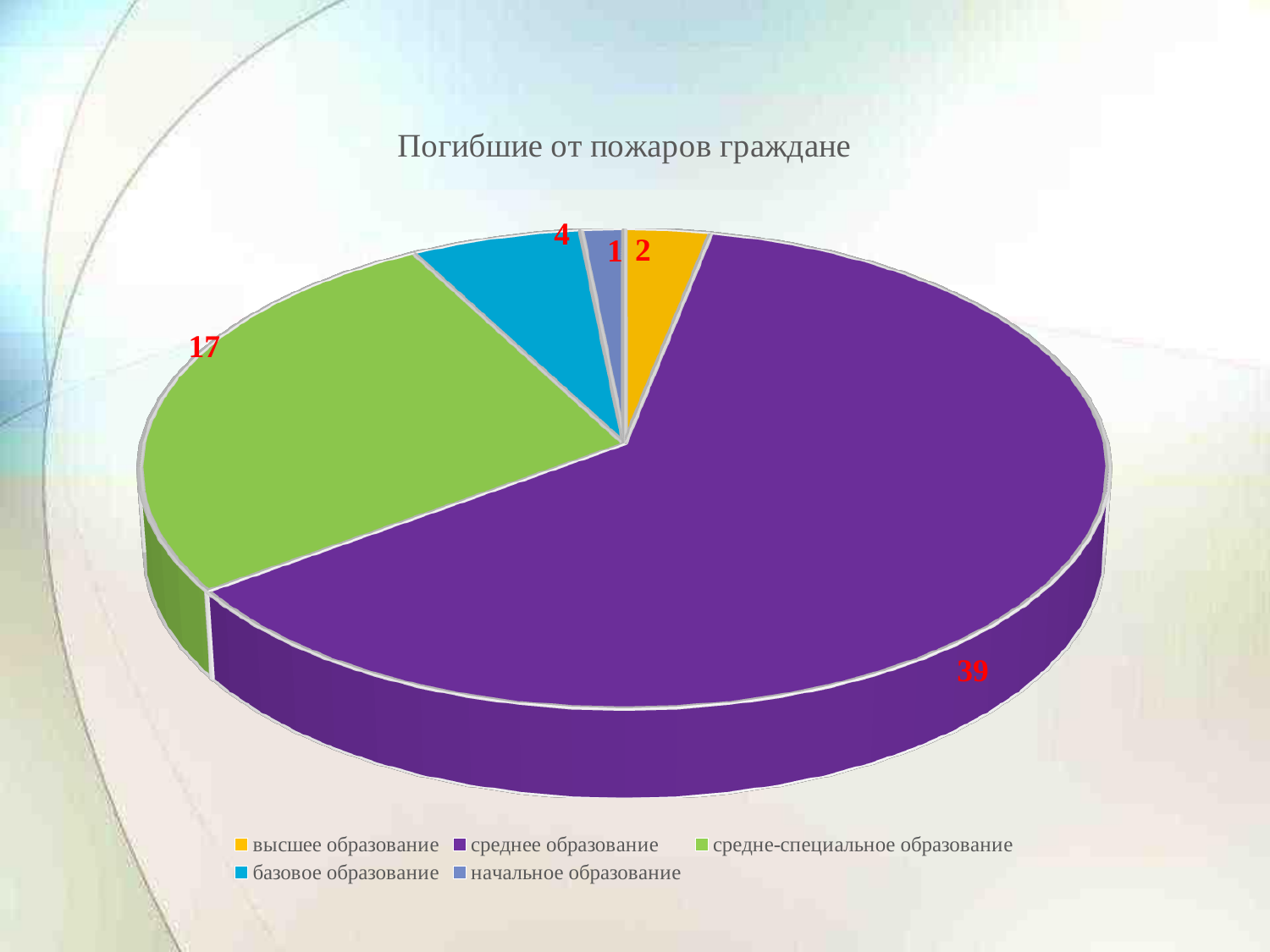
What is the value for среднее образование? 39 What is the title of the chart? Погибшие от пожаров граждане What is the value for высшее образование? 2 What kind of chart is shown on the slide? pie chart What is the value for базовое образование? 4 What is the total of all slices in the pie chart? 63 What is the value for средне-специальное образование? 17 What is the difference between the values for среднее образование and средне-специальное образование? 22 Which category has the smallest slice? начальное образование Which is larger, the value for базовое образование or the value for высшее образование? базовое образование How many categories does the pie chart show? 5 Which category has the largest slice? среднее образование